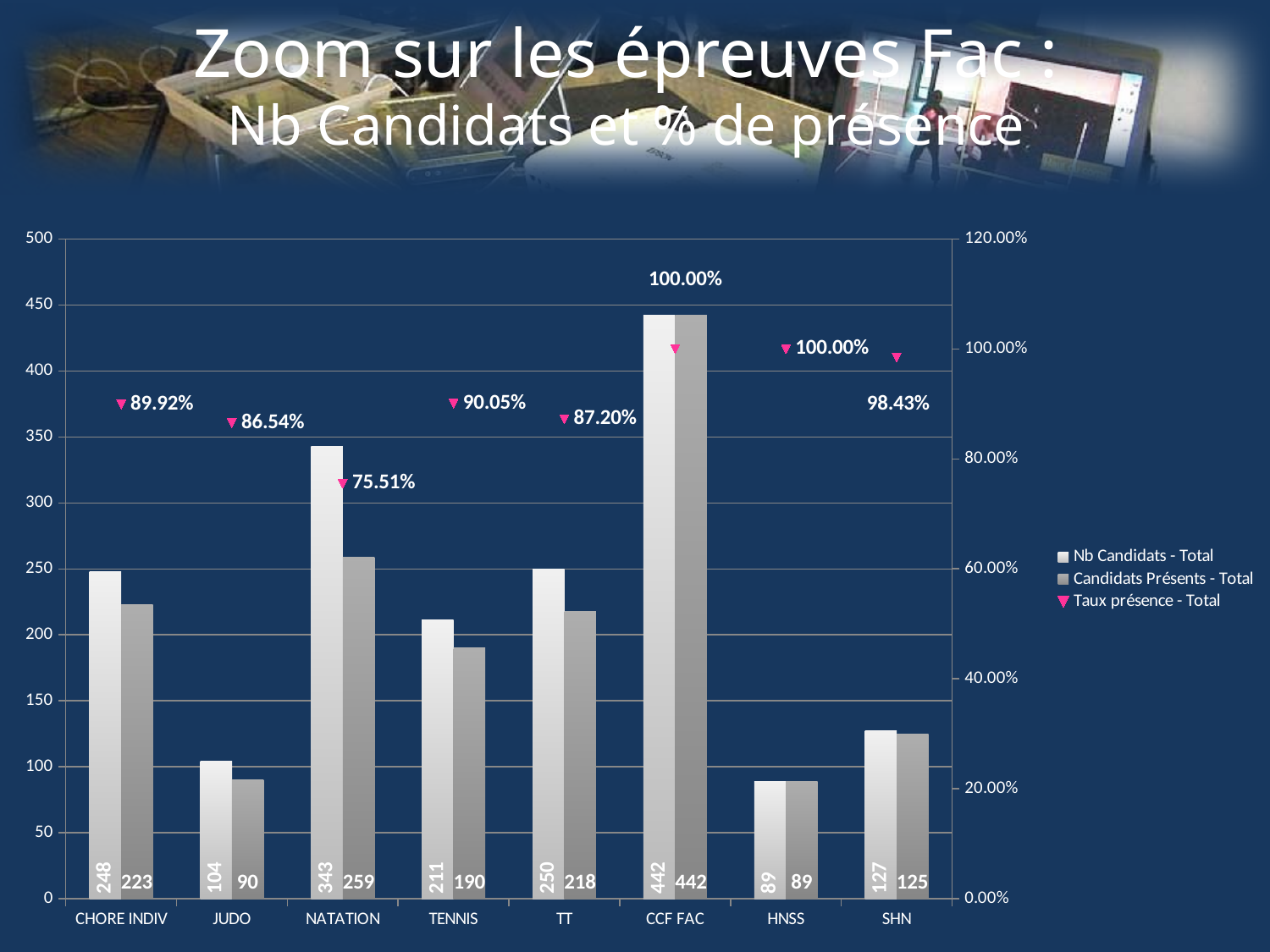
What is the value of Candidats Présents - Total for TENNIS? 190 What is the Taux présence - Total for SHN? 98.43% What is the Taux présence - Total for JUDO? 86.54% Which category has the lowest Taux présence - Total? NATATION How many series does the legend list? 3 What is the value of Nb Candidats - Total for NATATION? 343 What kind of chart is used for the Nb Candidats - Total series? Bar chart Which legend entry is shown with a pink triangle marker? Taux présence - Total Which category has the highest Nb Candidats - Total? CCF FAC What is the difference between Nb Candidats - Total and Candidats Présents - Total for NATATION? 84 Which is larger, the Nb Candidats - Total for TT or for CHORE INDIV? TT How many categories are shown on the x axis? 8